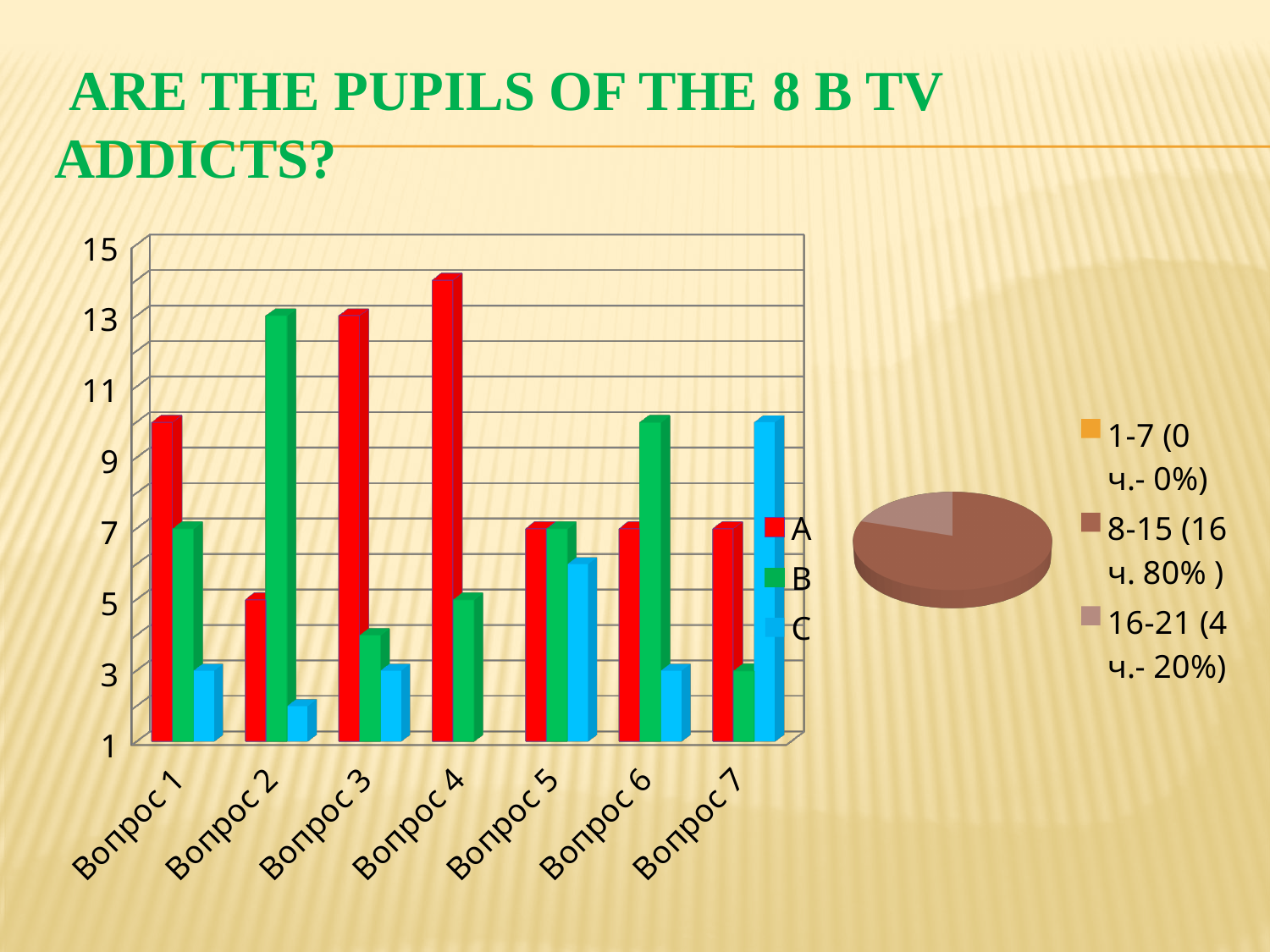
In the pie chart on the right, what share does the 16-21 group have? 20% In the pie chart on the right, which group has the largest slice? 8-15 (16 ч. 80% ) In the bar chart on the left, which is larger for Вопрос 7: series B or series C? C In the bar chart on the left, is the value of series A for Вопрос 4 greater or less than 11? greater In the bar chart on the left, which series has the highest value for Вопрос 2? B In the bar chart on the left, is the value of series B for Вопрос 6 greater or less than 9? greater How many series does the legend of the bar chart on the left list? 3 In the pie chart on the right, what share does the 8-15 group have? 80% What kind of chart is the chart on the left of the slide? bar chart In the bar chart on the left, is the value of series C for Вопрос 2 greater or less than 3? less In the bar chart on the left, which series is drawn in red? A How many categories (Вопрос) are shown on the x axis of the bar chart on the left? 7